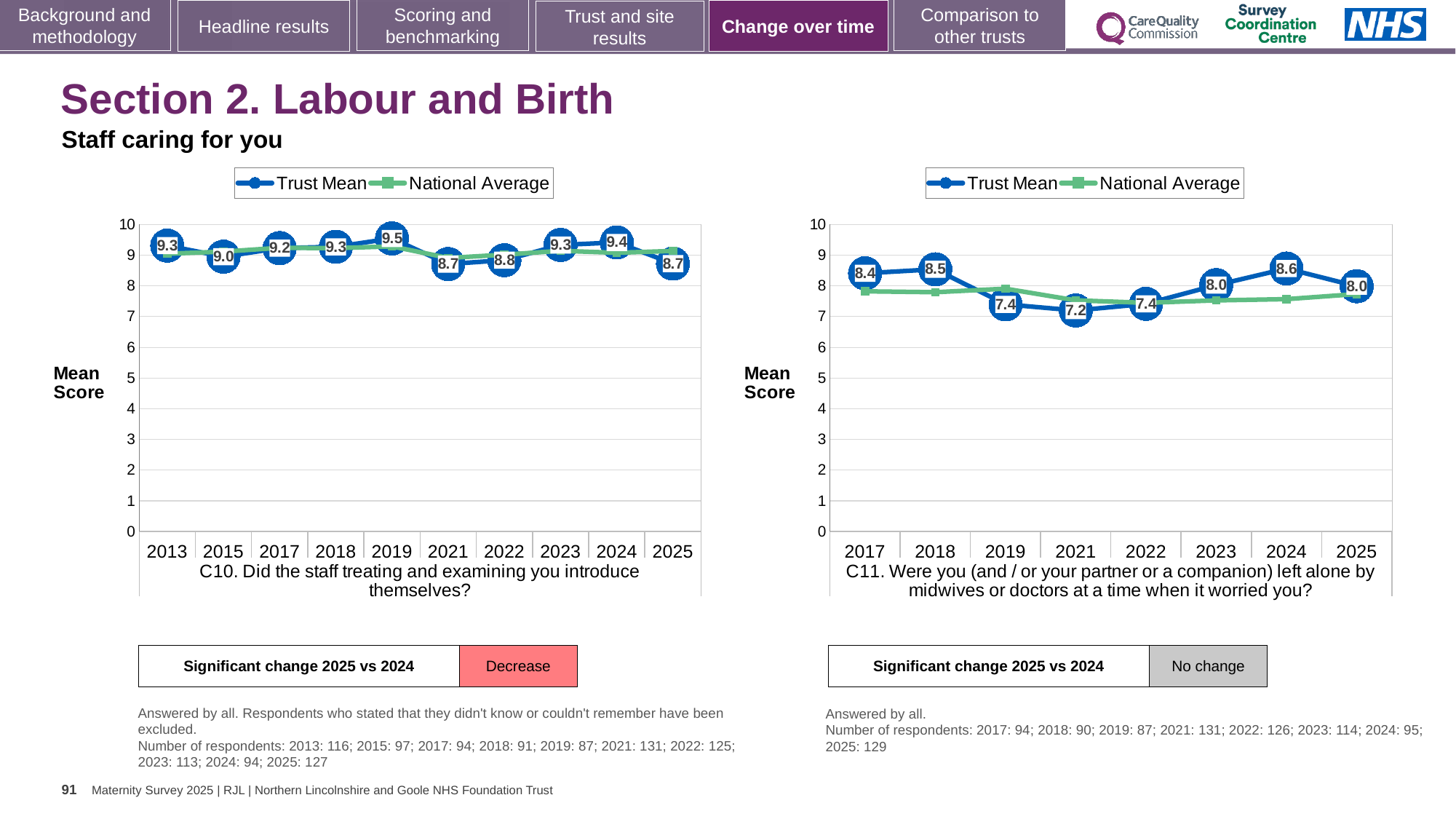
How many series does the legend of the right chart (C11) list? 2 What kind of chart is the right chart (C11)? Line chart On the left chart (C10), which year has the highest Trust Mean score? 2019 On the left chart (C10), what is the difference between the Trust Mean scores for 2024 and 2025? 0.7 On the right chart (C11), which is larger, the Trust Mean score for 2018 or for 2019? 2018 On the right chart (C11), what is the Trust Mean score for 2021? 7.2 On the right chart (C11), which year has the highest Trust Mean score? 2024 On the left chart (C10), is the National Average value for 2025 greater or less than 8? greater How many years are plotted on the left chart (C10)? 10 On the right chart (C11), which year has the lowest Trust Mean score? 2021 On the left chart (C10), what is the Trust Mean score for 2019? 9.5 On the right chart (C11), what is the difference between the Trust Mean scores for 2024 and 2025? 0.6